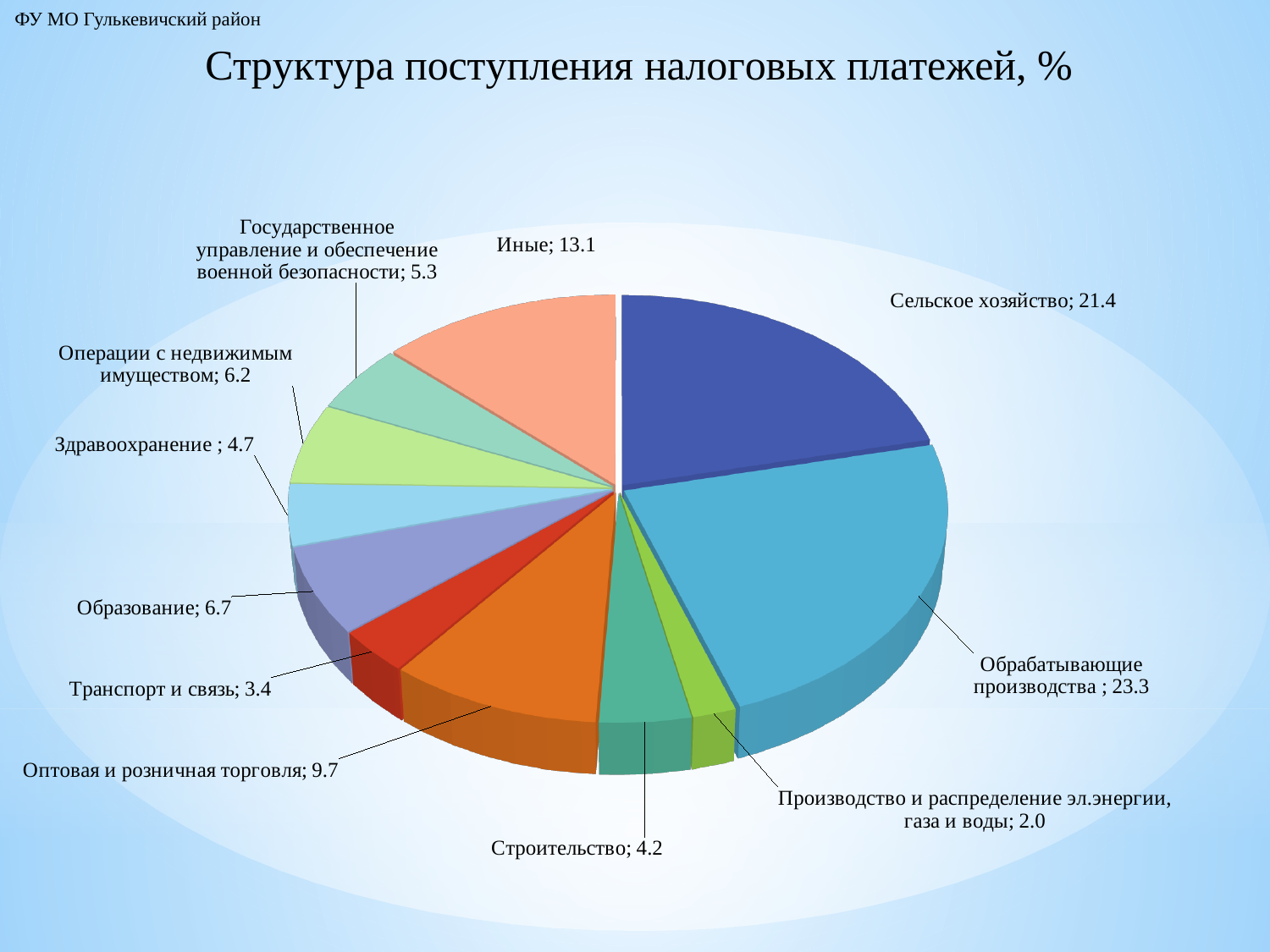
What is the value for Иные? 13.1 What is the value for Сельское хозяйство? 21.4 What is the value for Транспорт и связь? 3.4 What share of the pie does Здравоохранение represent? 4.7% What is the value for Оптовая и розничная торговля? 9.7 Which is larger, Образование or Операции с недвижимым имуществом? Образование What is the difference between the values for Обрабатывающие производства and Сельское хозяйство? 1.9 What is the title of the chart? Структура поступления налоговых платежей, % Which category has the smallest slice of the pie? Производство и распределение эл.энергии, газа и воды Which category has the largest slice of the pie? Обрабатывающие производства How many categories are shown in the pie chart? 11 What type of chart is shown on the slide? Pie chart